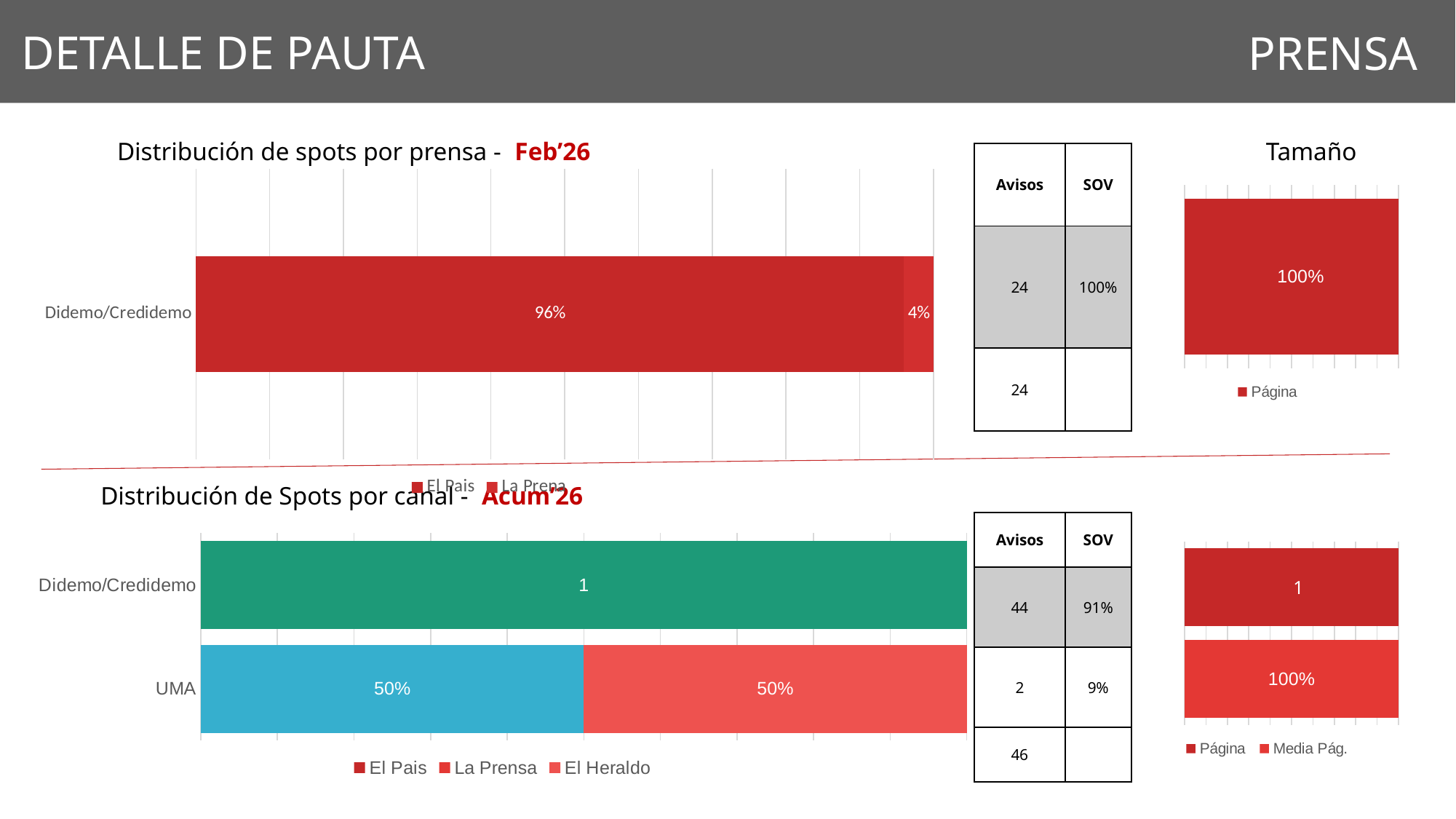
In the 'Distribución de spots por prensa - Feb'26' chart, which segment is larger for Didemo/Credidemo, El Pais or La Prensa? El Pais What is the only legend entry of the 'Tamaño' chart at the top right? Página How many categories are shown on the y axis of the 'Distribución de Spots por canal - Acum'26' chart? 2 In the 'Distribución de spots por prensa - Feb'26' chart, what share is labelled on the La Prensa segment for Didemo/Credidemo? 4% How many categories are shown on the y axis of the 'Distribución de spots por prensa - Feb'26' chart? 1 In the 'Tamaño' chart at the top right, what value is labelled on the bar? 100% What kind of chart is 'Distribución de spots por prensa - Feb'26'? Bar chart In the 'Distribución de Spots por canal - Acum'26' chart, what value is labelled on the left segment of the UMA bar? 50% How many entries does the legend of the 'Distribución de Spots por canal - Acum'26' chart list? 3 In the 'Distribución de spots por prensa - Feb'26' chart, what share is labelled on the El Pais segment for Didemo/Credidemo? 96% In the 'Distribución de Spots por canal - Acum'26' chart, what value is labelled on the Didemo/Credidemo bar? 1 In the 'Distribución de spots por prensa - Feb'26' chart, what is the difference in percentage points between the El Pais and La Prensa segments? 92 percentage points